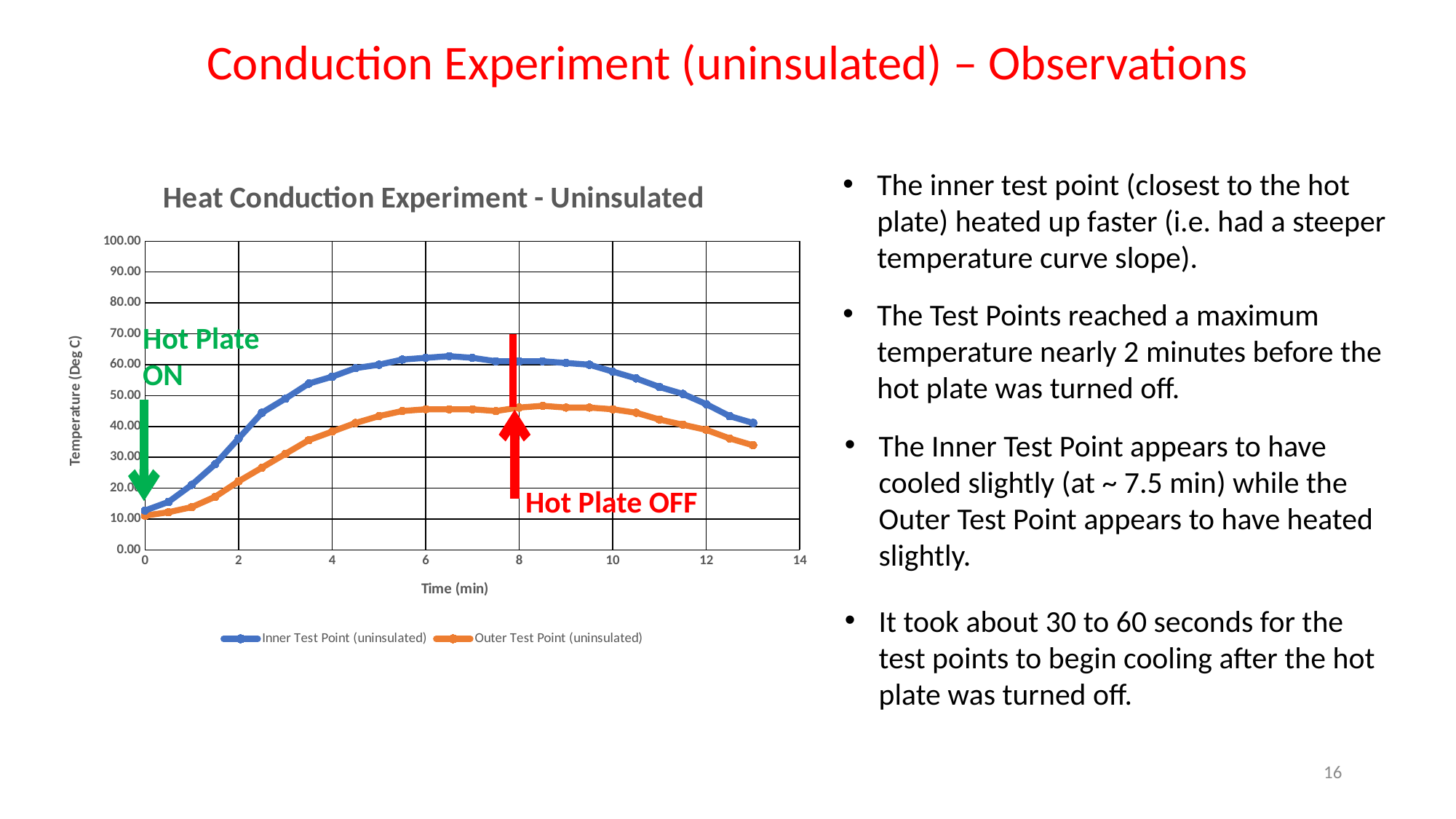
Is the value for Inner Test Point (uninsulated) at 0 minutes greater or less than 20.00? less Is the value for Inner Test Point (uninsulated) at 6 minutes greater or less than 50.00? greater Is the value for Outer Test Point (uninsulated) at 6 minutes greater or less than 50.00? less Does the Outer Test Point (uninsulated) temperature rise or fall between 10 and 13 minutes? fall What is the label on the vertical axis of the chart? Temperature (Deg C) What kind of chart is shown on the slide? line chart Does the Inner Test Point (uninsulated) temperature rise or fall between 0 and 6 minutes? rise At 4 minutes, which series has the higher temperature, Inner Test Point (uninsulated) or Outer Test Point (uninsulated)? Inner Test Point (uninsulated) What is the title of the chart? Heat Conduction Experiment - Uninsulated How many series does the chart legend list? 2